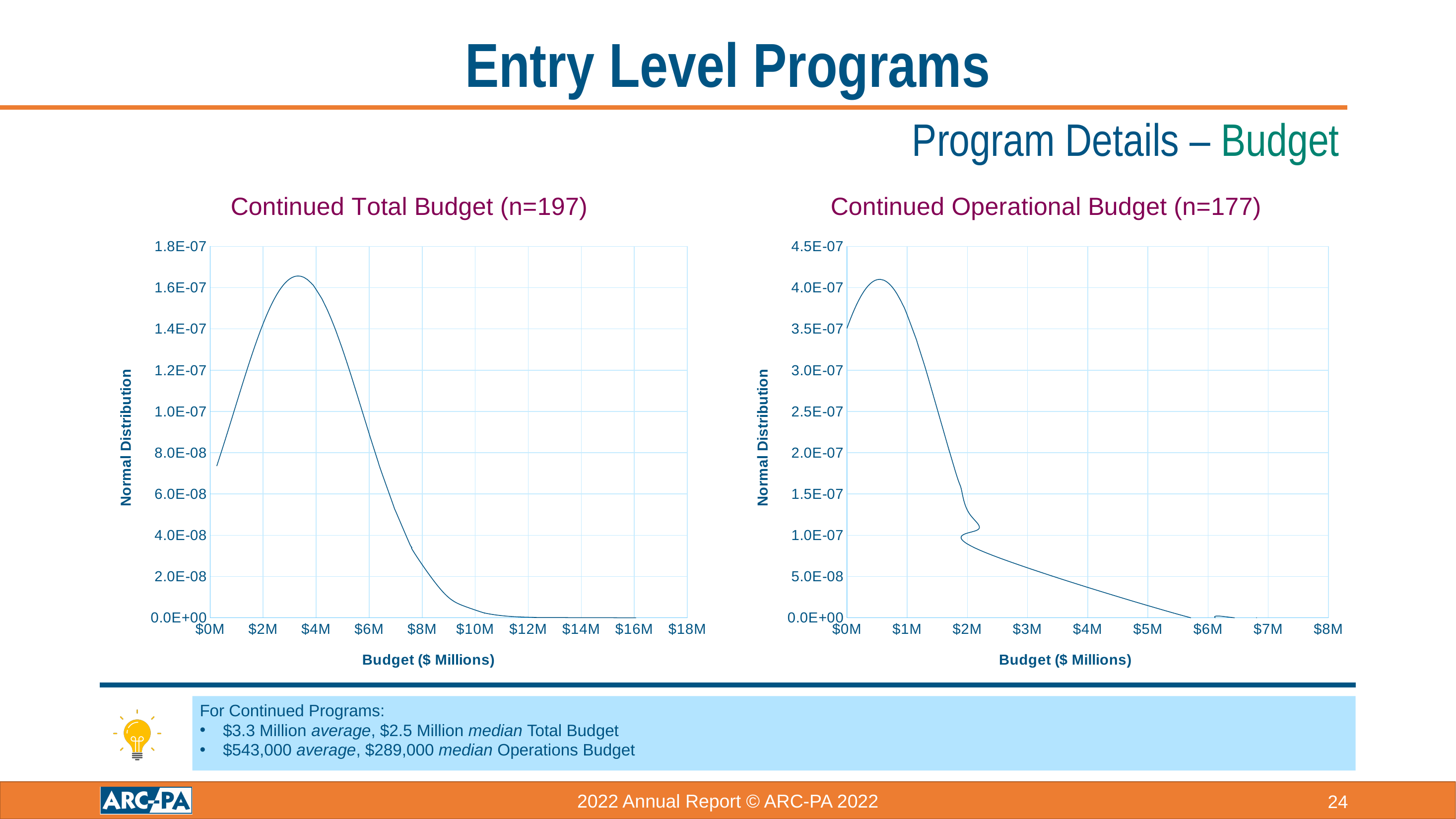
What is the highest x-axis tick shown on the Continued Total Budget chart? $18M In the Continued Operational Budget chart, is the peak value of the curve greater or less than 3.5E-07? greater In the Continued Total Budget chart, does the curve rise or fall between $4M and $8M on the x axis? fall In the Continued Operational Budget chart, is the value of the curve at $3M greater or less than 1.0E-07? less In the Continued Total Budget chart, is the peak value of the curve greater or less than 1.4E-07? greater How many charts are shown on the slide? 2 What kind of chart is the Continued Total Budget chart? line chart What is the y-axis label of the Continued Operational Budget chart? Normal Distribution In the Continued Operational Budget chart, does the curve rise or fall between $2M and $6M on the x axis? fall What is the highest y-axis tick shown on the Continued Operational Budget chart? 4.5E-07 What is the title of the chart on the left side of the slide? Continued Total Budget (n=197)